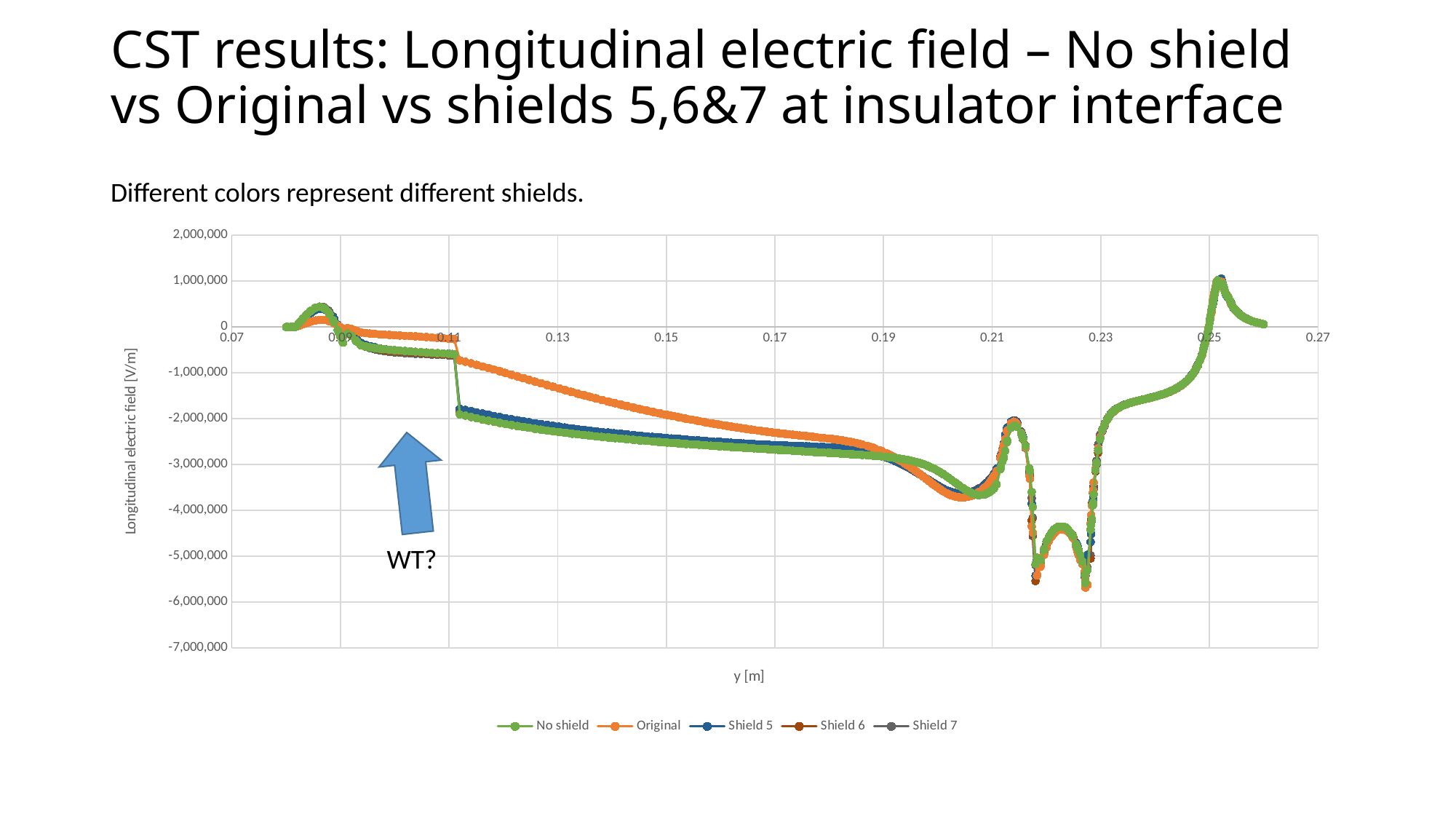
How many series does the legend list? 5 Is the lowest value reached by any series on the chart greater or less than -5,000,000? less Which series has the highest value at y = 0.15? Original Is the value of the No shield series at y = 0.15 greater or less than -2,000,000? less Which series are listed in the legend? No shield, Original, Shield 5, Shield 6, Shield 7 Between y = 0.11 and y = 0.19, do the values of the No shield series rise or fall? fall Is the value of the Original series at y = 0.13 greater or less than -2,000,000? greater What is the label of the vertical axis? Longitudinal electric field [V/m] At y = 0.15, which series has the larger value, Original or No shield? Original What kind of chart is shown on the slide? line chart